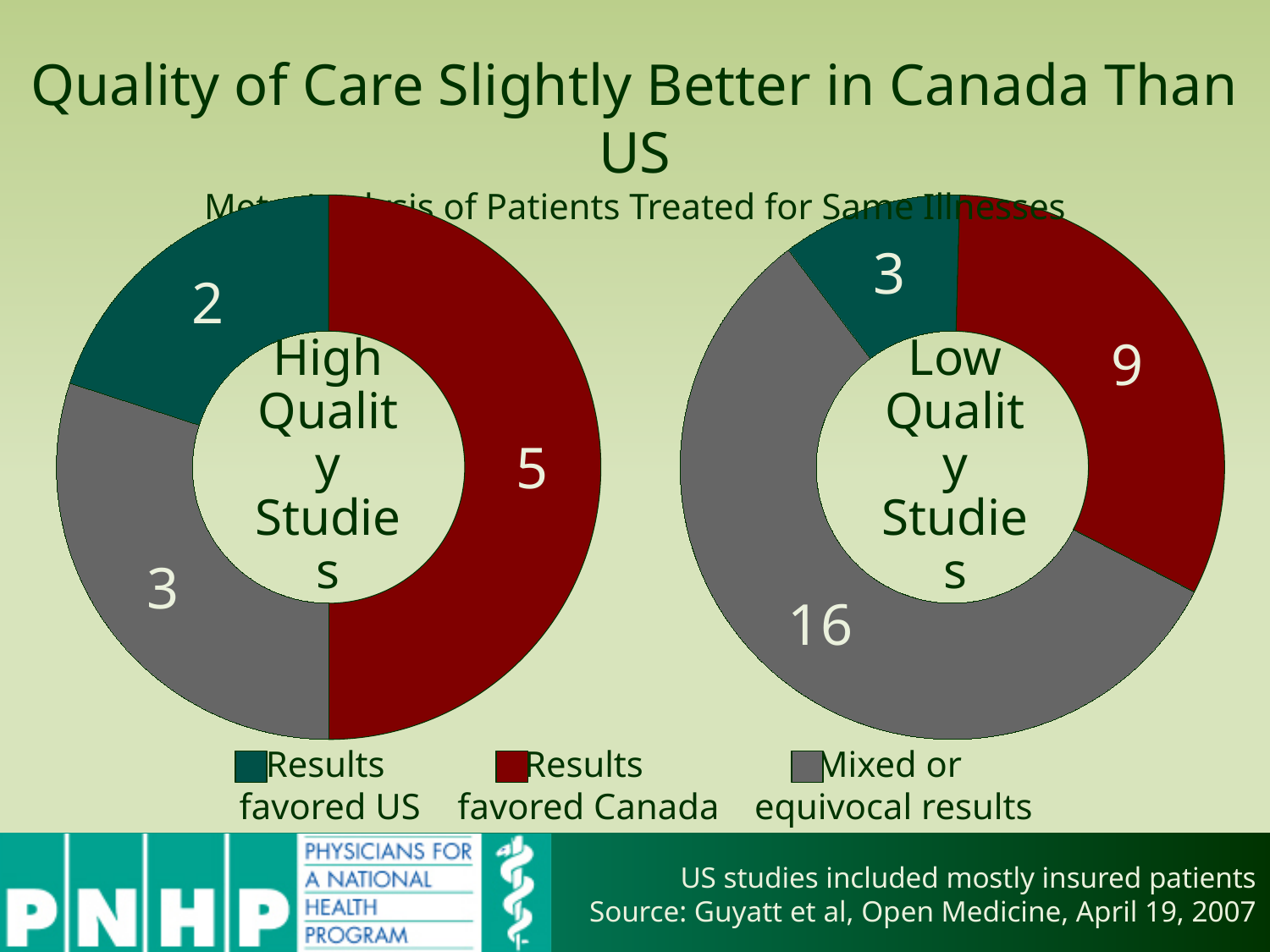
In the High Quality Studies chart, which category has the smallest number of studies? Results favored US In the Low Quality Studies chart, how many studies had results favoring Canada? 9 What is the total number of studies shown in the Low Quality Studies chart? 28 In the High Quality Studies chart, how many studies had results favoring the US? 2 What is the total number of studies shown in the High Quality Studies chart? 10 In the Low Quality Studies chart, how many studies had mixed or equivocal results? 16 In the High Quality Studies chart, which is larger: the number of studies favoring Canada or the number with mixed or equivocal results? Results favored Canada How many categories does the legend list for the charts? 3 In the Low Quality Studies chart, what is the difference between the number of studies with mixed or equivocal results and the number favoring Canada? 7 In the High Quality Studies chart, how many studies had results favoring Canada? 5 In the Low Quality Studies chart, which category has the largest number of studies? Mixed or equivocal results What type of chart is used for the High Quality Studies data? Doughnut chart